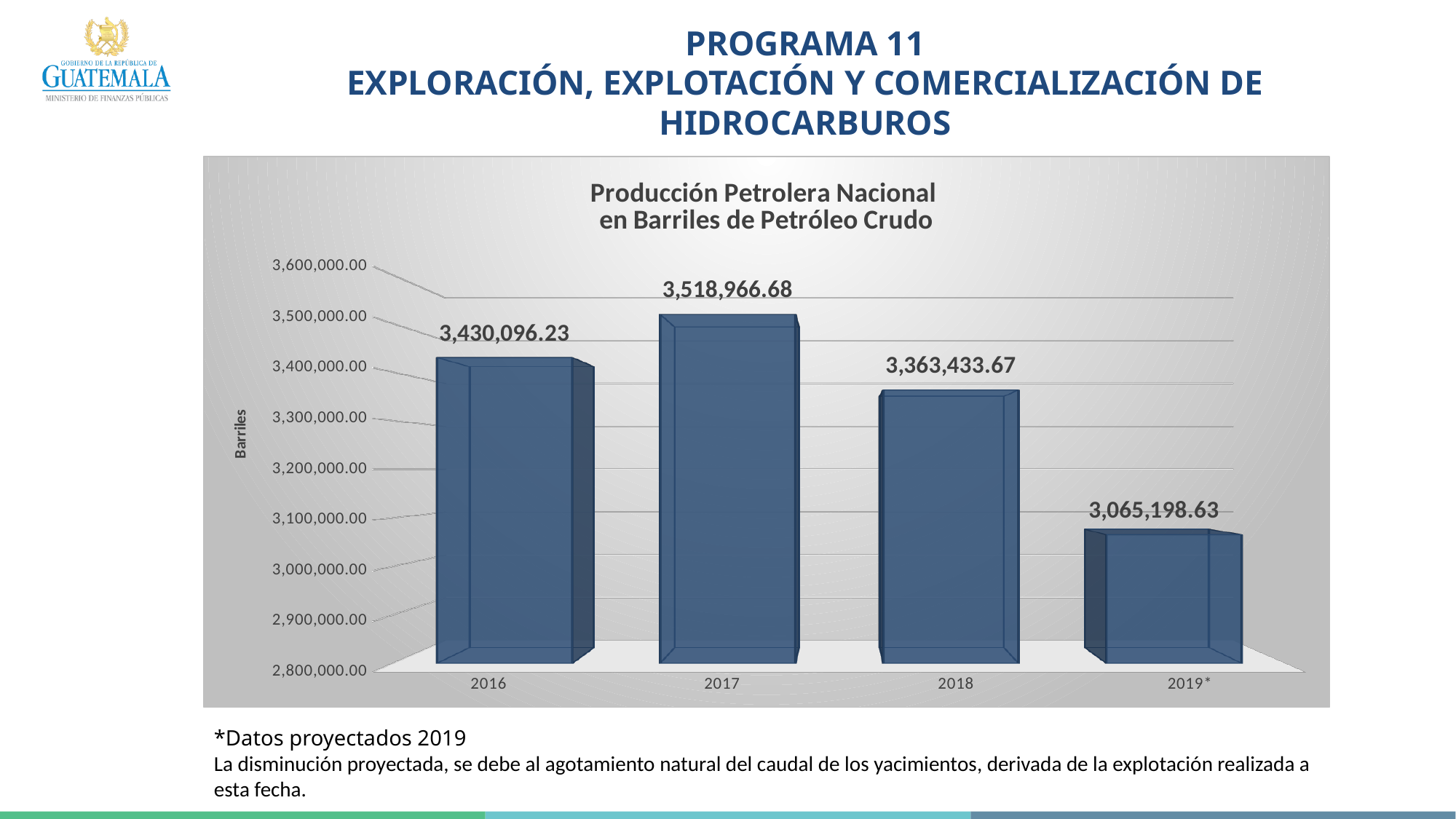
What is the difference between the values for 2017 and 2016? 88,870.45 What is the value for 2017 in the chart? 3,518,966.68 Which year has the lowest production in the chart? 2019* How many years are shown on the x axis of the chart? 4 What kind of chart is shown on the slide? Bar chart What is the value for 2018 in the chart? 3,363,433.67 Which is larger, the value for 2016 or the value for 2018? 2016 Which year has the highest production in the chart? 2017 What is the projected value for 2019* in the chart? 3,065,198.63 What is the difference between the values for 2018 and 2019*? 298,235.04 What is the title of the chart? Producción Petrolera Nacional en Barriles de Petróleo Crudo What is the value for 2016 in the chart? 3,430,096.23